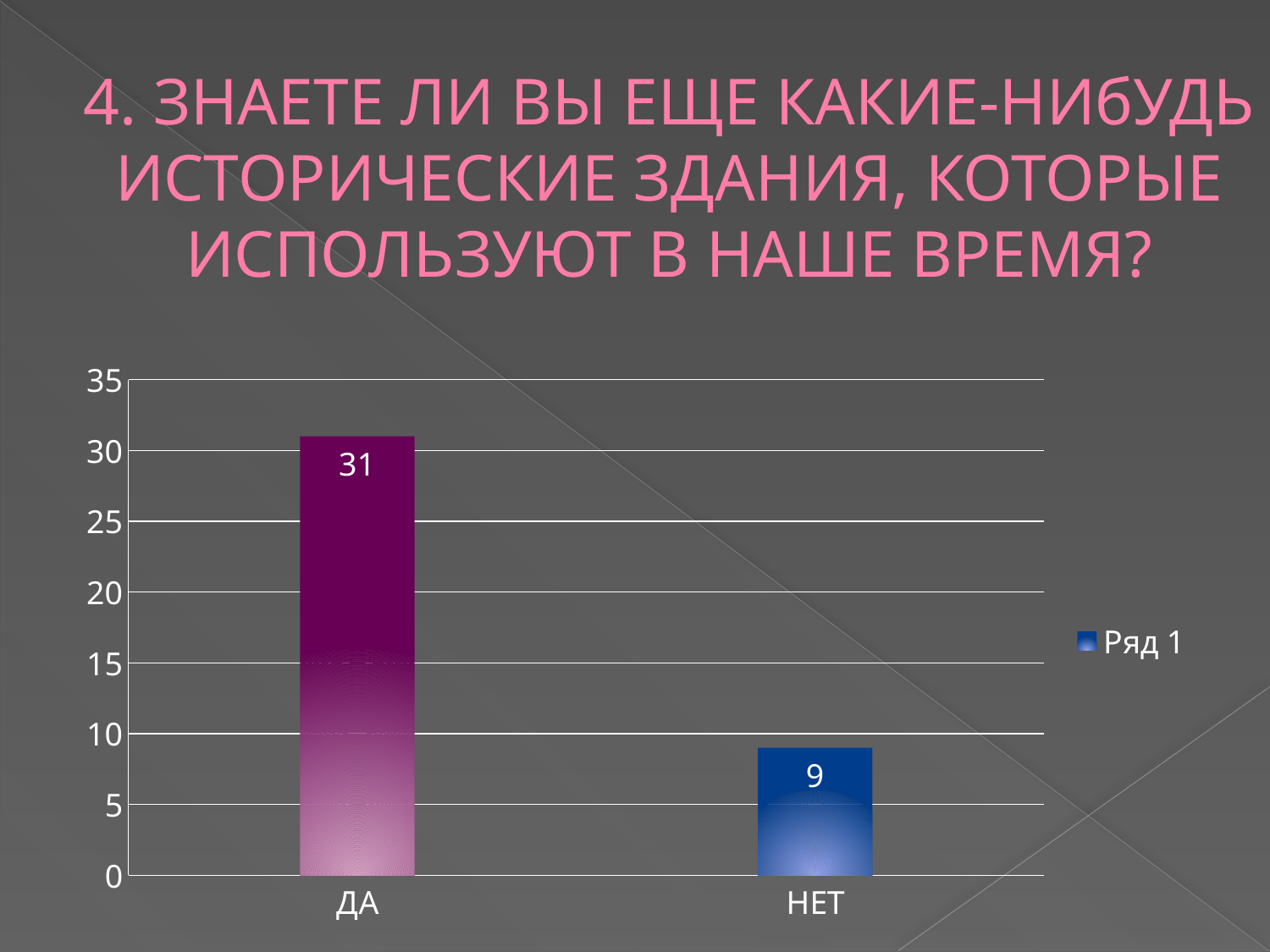
How many series does the legend list? 1 What is the name of the series listed in the legend? Ряд 1 What is the value for ДА? 31 Which is larger, the value for ДА or the value for НЕТ? ДА What kind of chart is shown on the slide? bar chart Is the value for ДА greater or less than 30? greater What is the difference between the values for ДА and НЕТ? 22 What is the value for НЕТ? 9 Is the value for НЕТ greater or less than 10? less Which category has the lowest value? НЕТ How many categories are shown on the x axis? 2 Which category has the highest value? ДА